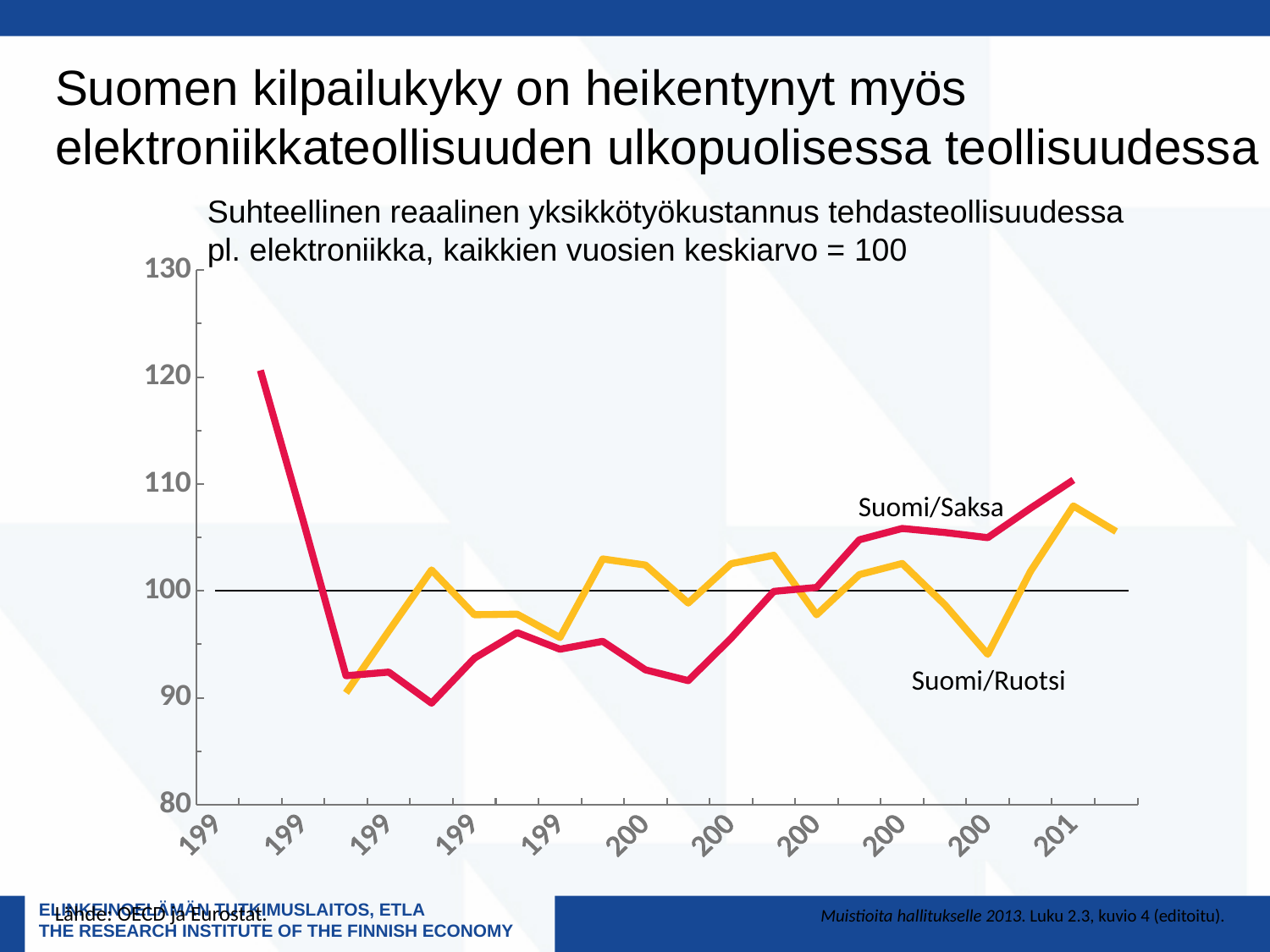
Which series reaches the highest value anywhere on the chart? Suomi/Saksa What are the names of the two series plotted on the chart? Suomi/Saksa and Suomi/Ruotsi What kind of chart is shown on the slide? Line chart Is the highest value of the Suomi/Saksa series greater or less than 110? greater What is the highest value shown on the vertical axis? 130 Which series is drawn in red? Suomi/Saksa At what value is the horizontal reference line drawn on the chart? 100 Is the first plotted value of the Suomi/Saksa series greater or less than 110? greater Is the highest value of the Suomi/Ruotsi series greater or less than 100? greater How many series are plotted on the chart? 2 What is the lowest value shown on the vertical axis? 80